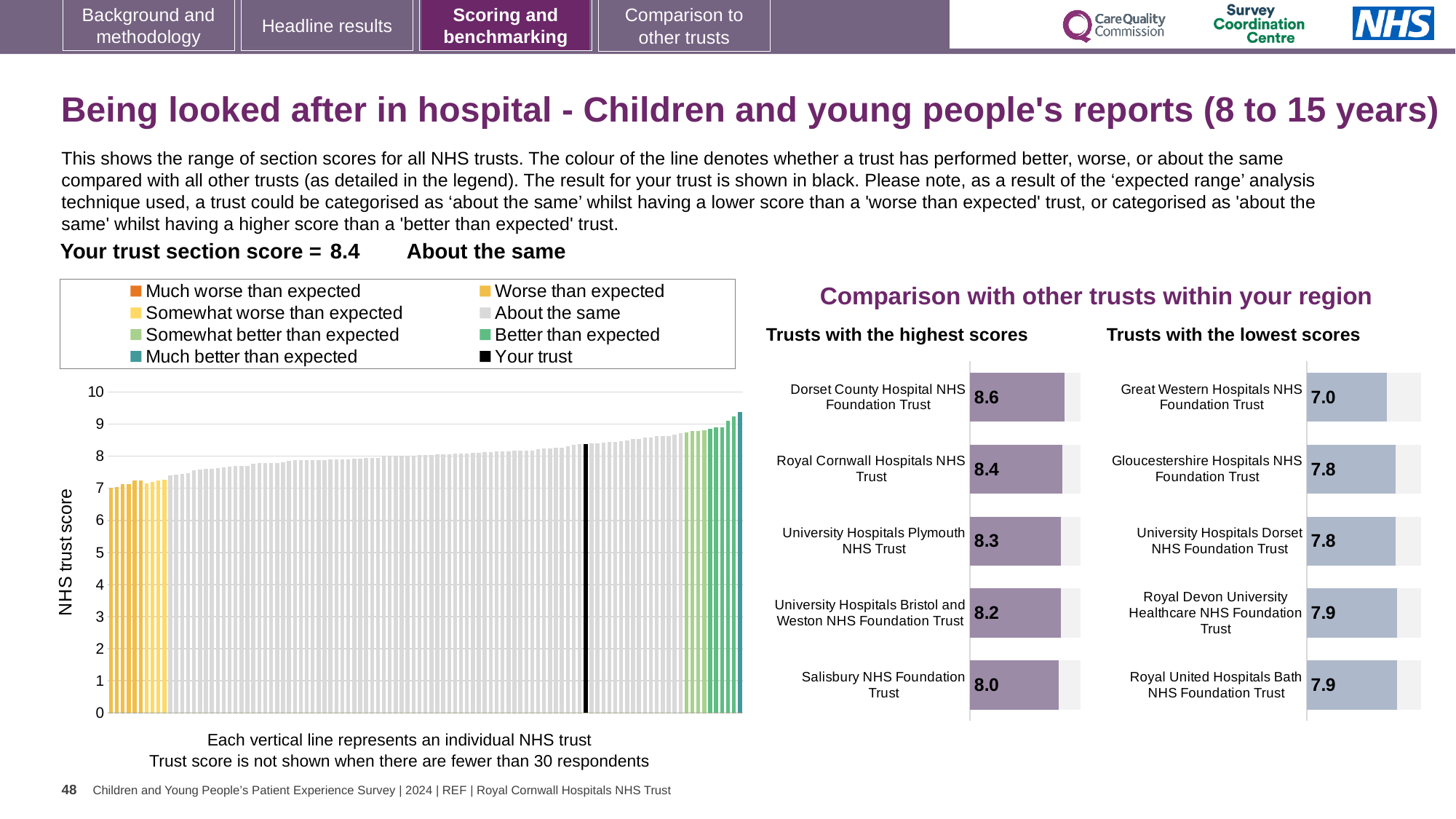
In the 'Trusts with the highest scores' chart, what is the score for Salisbury NHS Foundation Trust? 8.0 Which is larger: the score for Royal Cornwall Hospitals NHS Trust in the 'Trusts with the highest scores' chart or the score for Gloucestershire Hospitals NHS Foundation Trust in the 'Trusts with the lowest scores' chart? Royal Cornwall Hospitals NHS Trust In the 'Trusts with the lowest scores' chart, which trust has the lowest score? Great Western Hospitals NHS Foundation Trust In the 'Trusts with the highest scores' chart, which trust has the highest score? Dorset County Hospital NHS Foundation Trust How many trusts are shown in the 'Trusts with the highest scores' chart? 5 In the 'Trusts with the lowest scores' chart, what is the difference between the scores of Royal Devon University Healthcare NHS Foundation Trust and Great Western Hospitals NHS Foundation Trust? 0.9 In the large chart on the left, is the value for the black bar (your trust) greater or less than 8? greater In the 'Trusts with the highest scores' chart, what is the difference between the scores of Dorset County Hospital NHS Foundation Trust and Salisbury NHS Foundation Trust? 0.6 In the 'Trusts with the lowest scores' chart, what is the score for Royal United Hospitals Bath NHS Foundation Trust? 7.9 How many entries does the legend of the large chart on the left list? 8 In the 'Trusts with the lowest scores' chart, what is the score for Great Western Hospitals NHS Foundation Trust? 7.0 In the 'Trusts with the highest scores' chart, what is the score for Dorset County Hospital NHS Foundation Trust? 8.6